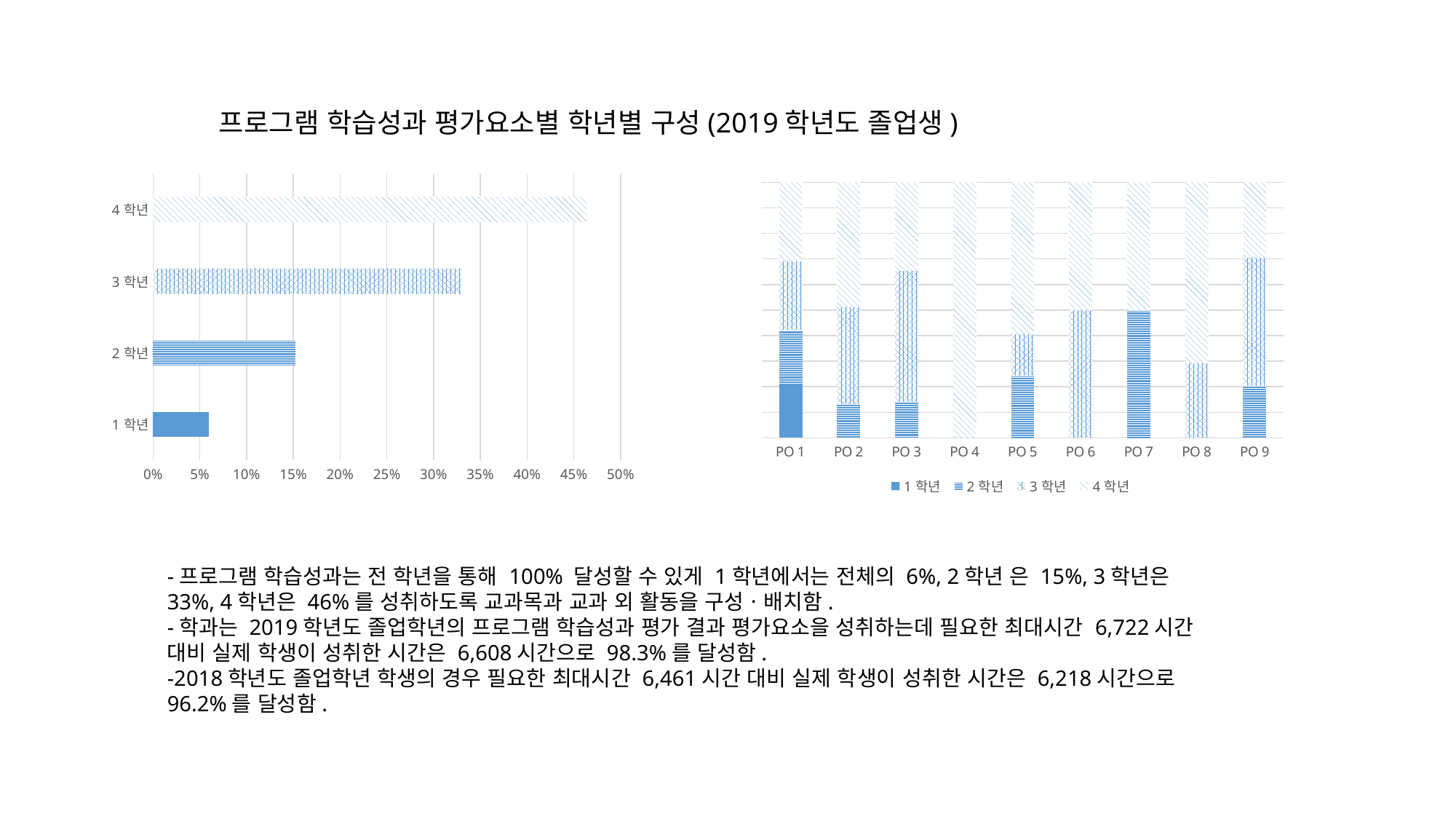
What kind of chart is the chart on the left of the slide? bar chart In the chart on the left, which 학년 has the highest value? 4 학년 In the chart on the left, what is the value for 2 학년? 15% What kind of chart is the chart on the right of the slide? stacked bar chart In the chart on the left, which 학년 has the lowest value? 1 학년 In the chart on the left, which is larger, the value for 3 학년 or the value for 2 학년? 3 학년 In the chart on the right, how many series does the legend list? 4 In the chart on the left, how many 학년 categories are shown? 4 In the chart on the left, is the value for 4 학년 greater or less than 40%? greater In the chart on the left, is the value for 1 학년 greater or less than 10%? less In the chart on the right, how many PO categories are shown on the x axis? 9 In the chart on the left, is the value for 3 학년 greater or less than 30%? greater